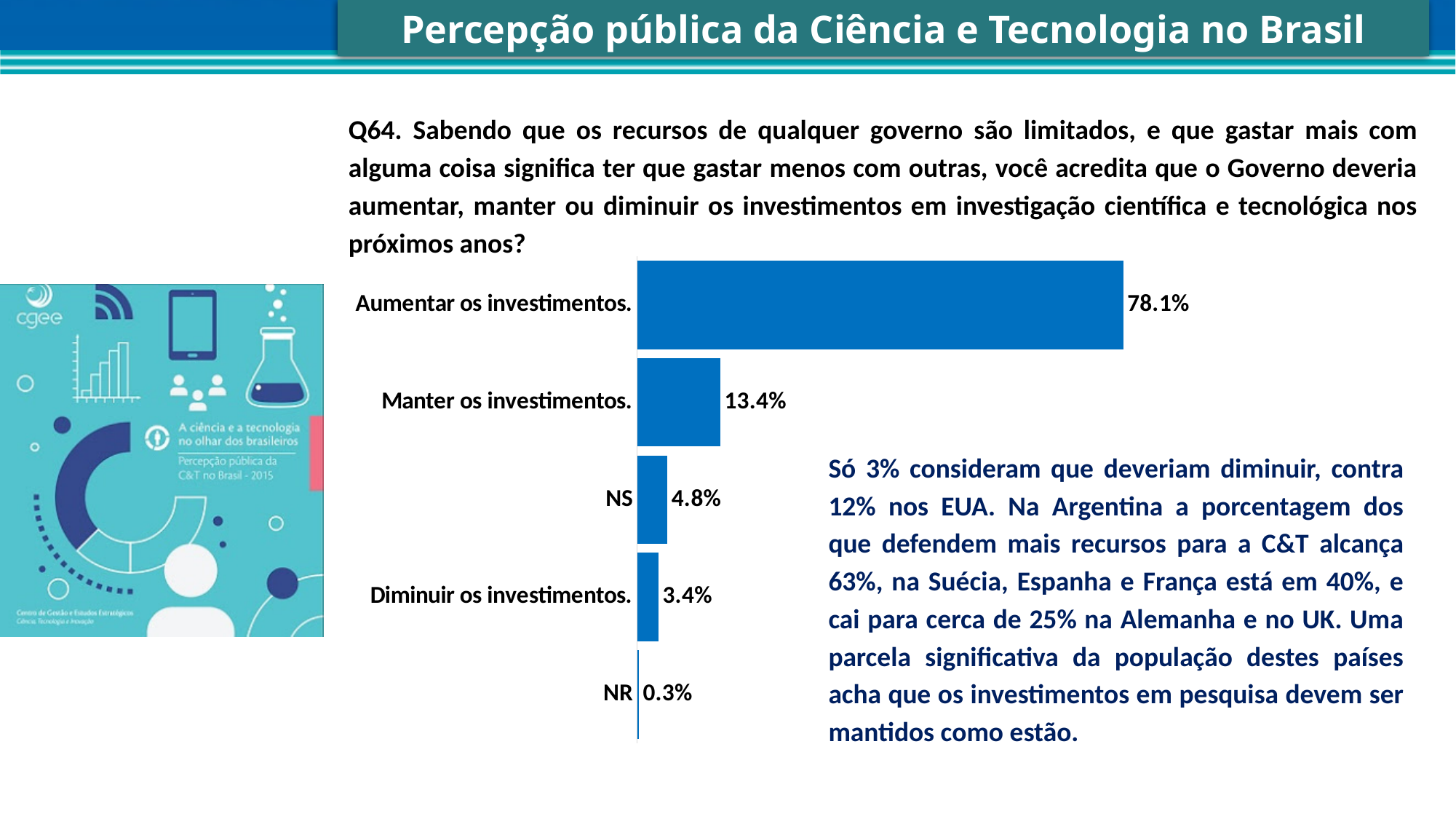
What is the value for "Manter os investimentos."? 13.4% How many categories are shown in the chart? 5 What is the value for "NS"? 4.8% Which is larger, the value for "NS" or the value for "Diminuir os investimentos."? NS What kind of chart is shown on the slide? Bar chart Which category has the highest value? Aumentar os investimentos. What is the value for "NR"? 0.3% What is the value for "Diminuir os investimentos."? 3.4% What is the difference between the values for "NS" and "Diminuir os investimentos."? 1.4% Which category has the lowest value? NR What is the value for "Aumentar os investimentos."? 78.1% What is the difference between the values for "Aumentar os investimentos." and "Manter os investimentos."? 64.7%